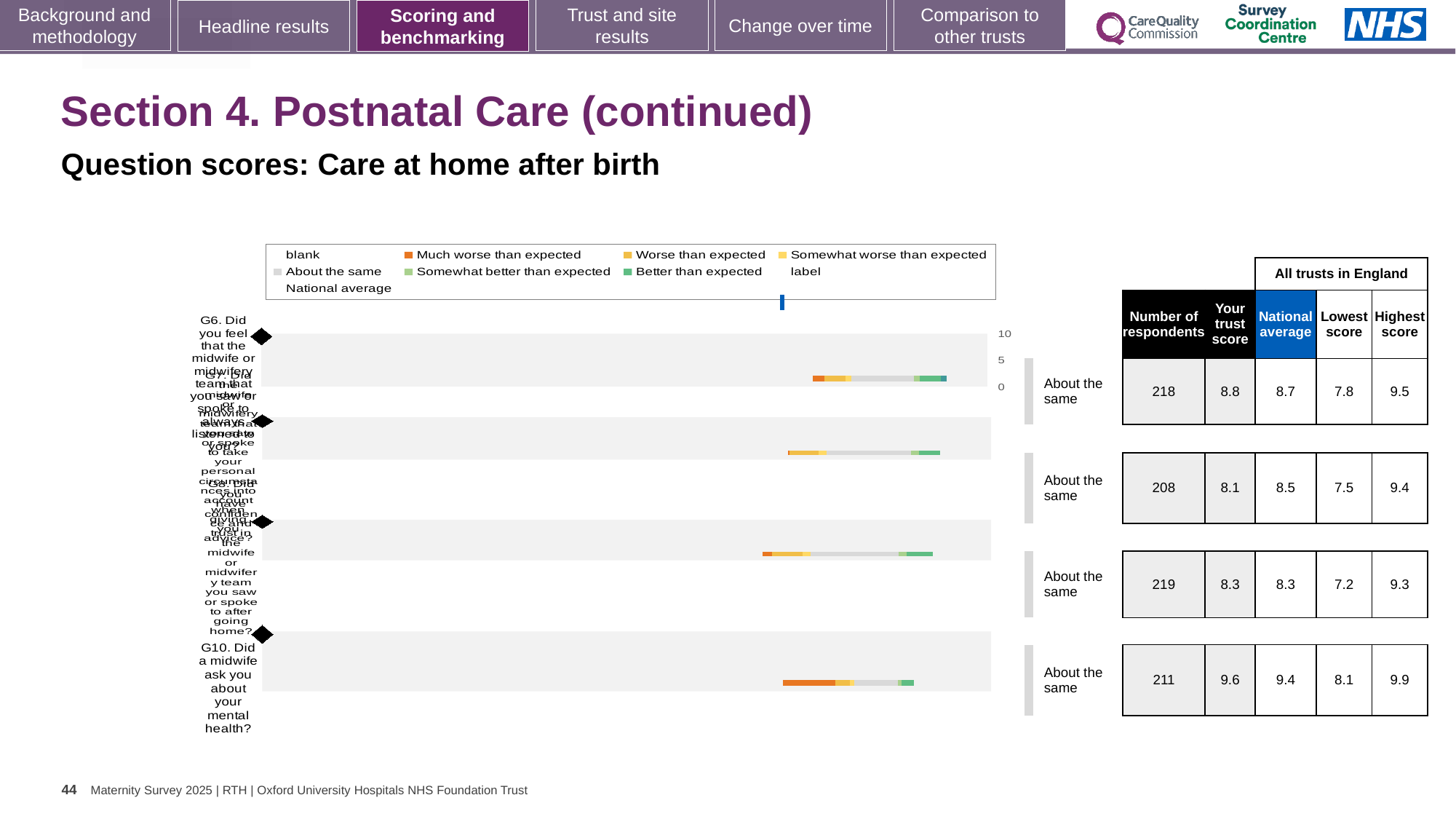
How many respondents answered G6 (the first question row)? 218 What is the highest score across all trusts in England for G10 (mental health)? 9.9 What is the 'Your trust score' for G10 (Did a midwife ask you about your mental health?)? 9.6 What is the lowest 'Your trust score' among the four question rows? 8.1 How many question rows (bars) are plotted in the chart? 4 Which question row has the highest 'Your trust score'? G10 (mental health), 9.6 What is the lowest score across all trusts in England for G6 (the first question row)? 7.8 For G6 (the first question row), which is larger: the trust score or the national average? the trust score (8.8) What kind of chart is shown on the slide? bar chart What is the national average for G10 (Did a midwife ask you about your mental health?)? 9.4 By how much does the trust score for G10 exceed the national average for G10? 0.2 What benchmark category is shown for all four question rows? About the same